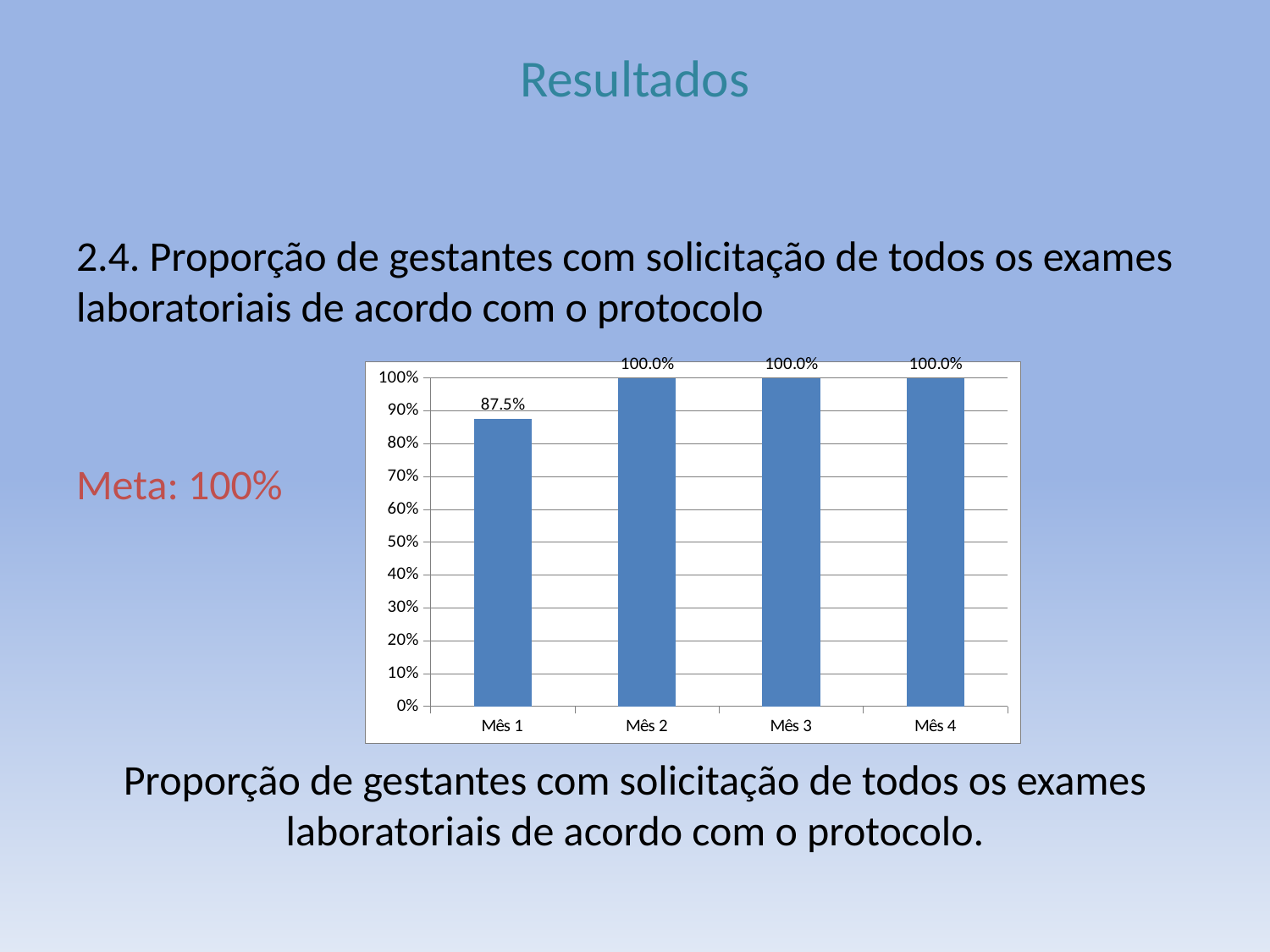
How many months reach the 100.0% value? 3 What kind of chart is shown on the slide? bar chart What is the value for Mês 2? 100.0% What is the target (Meta) stated on the slide? 100% What is the value for Mês 1? 87.5% Which month has the lowest value? Mês 1 Which is larger, the value for Mês 1 or the value for Mês 3? Mês 3 Is the value for Mês 1 greater or less than 80%? greater How many months are shown on the x axis? 4 What is the difference between the values for Mês 2 and Mês 1? 12.5% Do the values rise or fall from Mês 1 to Mês 2? rise What is the value for Mês 4? 100.0%